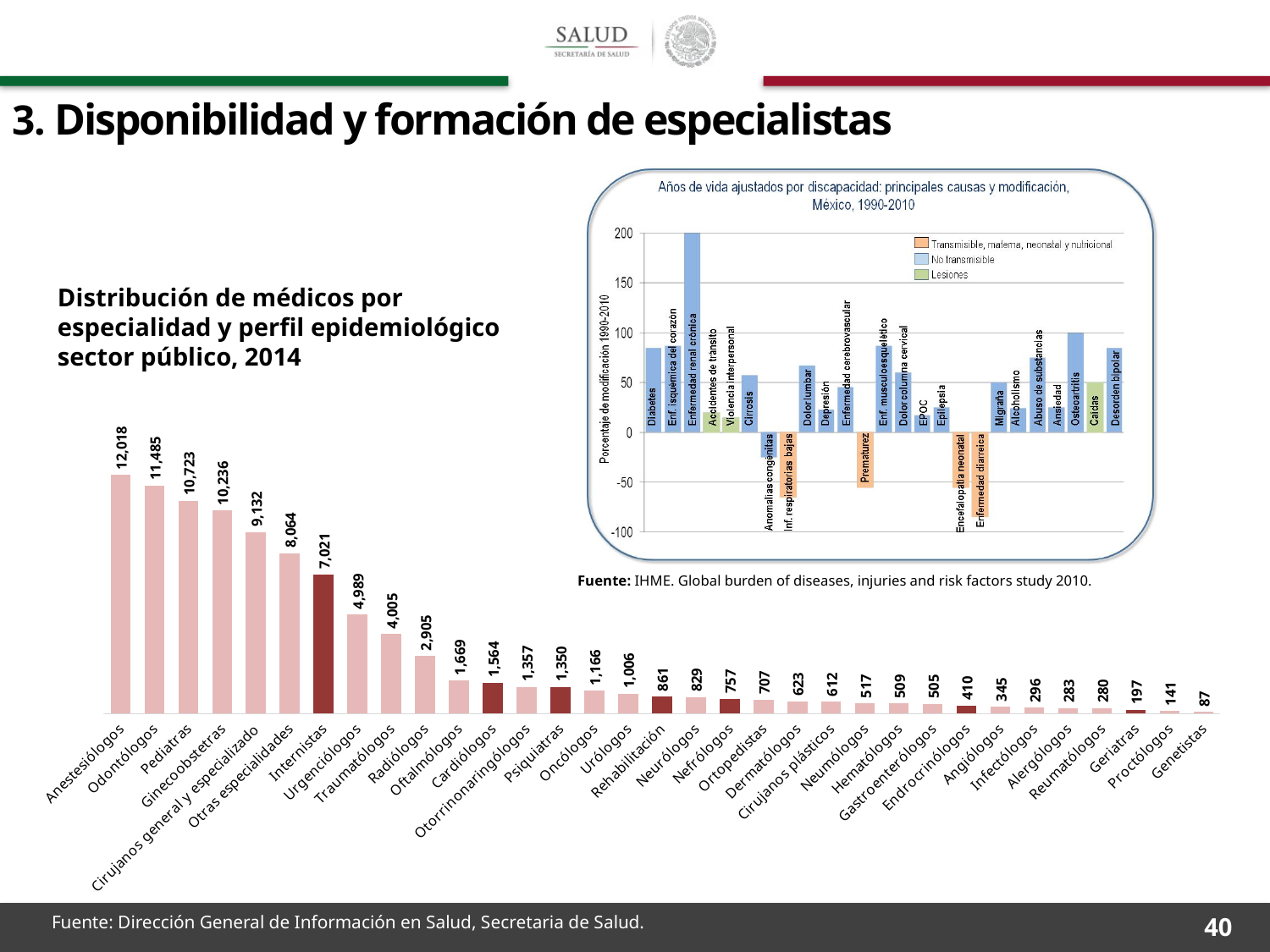
On the 'Años de vida ajustados por discapacidad' chart, how many series does the legend list? 3 On the 'Distribución de médicos por especialidad' chart, which specialty has the highest value? Anestesiólogos On the 'Distribución de médicos por especialidad' chart, what is the value for Geriatras? 197 On the 'Distribución de médicos por especialidad' chart, how many médicos are shown for Anestesiólogos? 12,018 On the 'Distribución de médicos por especialidad' chart, do the values rise or fall from left to right? fall What kind of chart is the 'Distribución de médicos por especialidad' chart? bar chart On the 'Años de vida ajustados por discapacidad' chart, is the value for Diabetes greater or less than 50? greater On the 'Distribución de médicos por especialidad' chart, how many specialties are plotted? 33 On the 'Distribución de médicos por especialidad' chart, what is the difference between Odontólogos and Pediatras? 762 On the 'Distribución de médicos por especialidad' chart, which is larger, Urgenciólogos or Traumatólogos? Urgenciólogos On the 'Distribución de médicos por especialidad' chart, what is the value for Internistas? 7,021 On the 'Distribución de médicos por especialidad' chart, which specialty has the lowest value? Genetistas